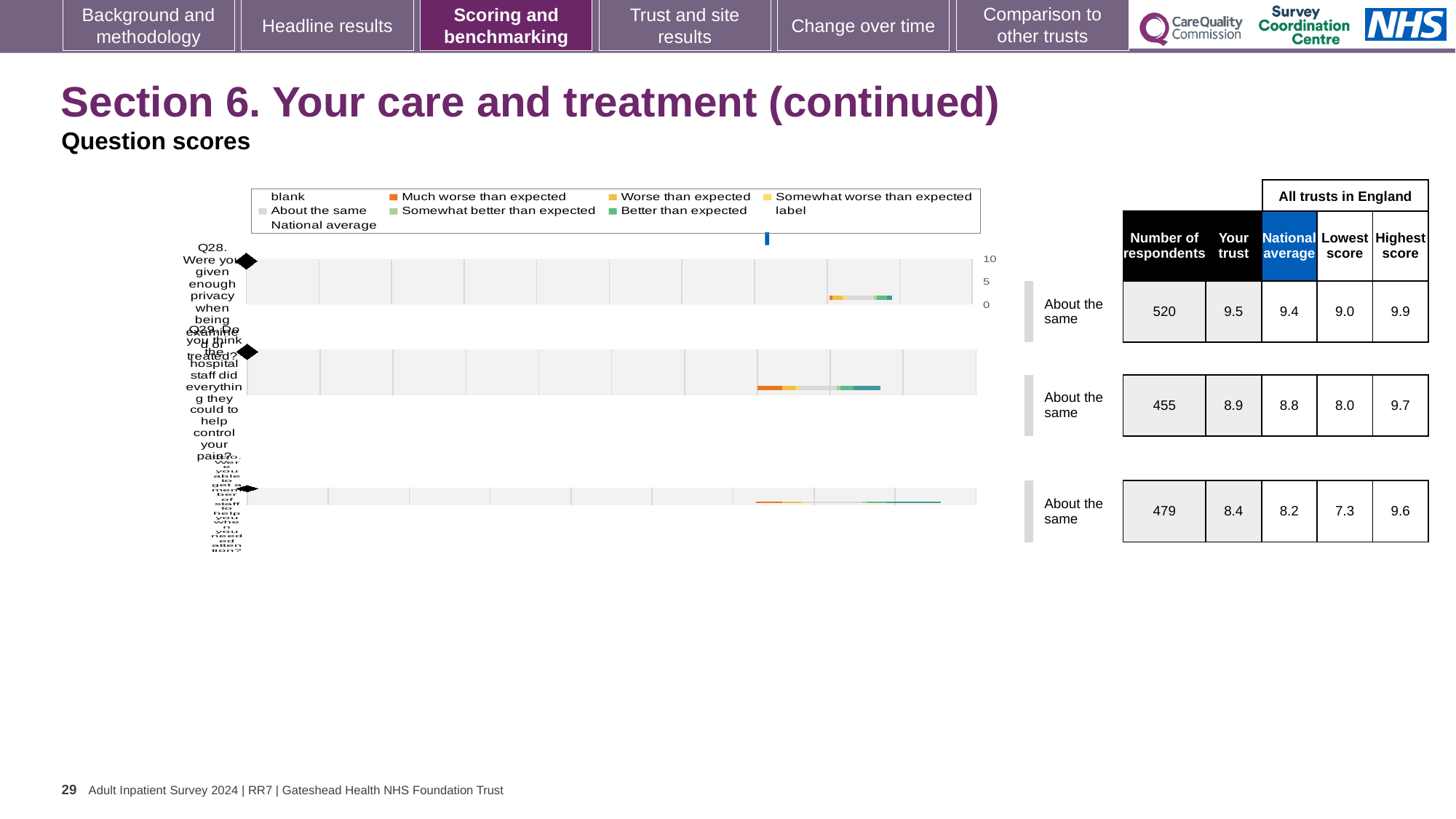
What is the difference between the 'Your trust' score and the national average for Q28? 0.1 Which question has the highest 'Your trust' score? Q28 How many respondents answered Q30? 479 What benchmark category is shown for Q28? About the same For Q29, which is larger: the 'Your trust' score or the national average? Your trust What kind of chart is used to show the question scores on this slide? bar chart How many questions are plotted in the chart on this slide? 3 What is the 'Your trust' score for Q28 (enough privacy when being examined or treated)? 9.5 What colour does the legend use for 'Much worse than expected'? orange Which question has the lowest 'Lowest score' across all trusts in England? Q30 What is the difference between the highest score and the lowest score for Q30? 2.3 What is the national average score for Q29 (hospital staff did everything to help control pain)? 8.8